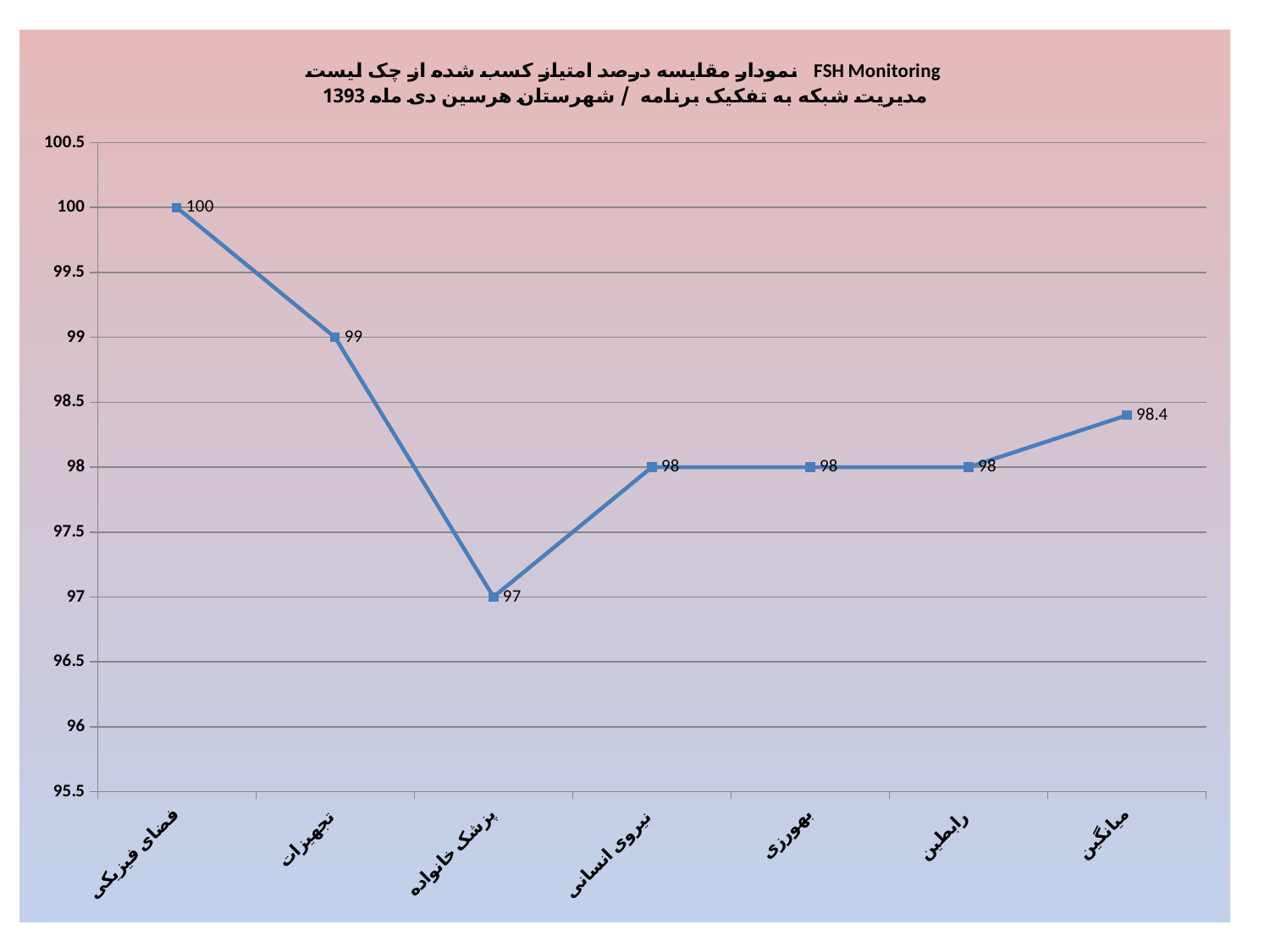
What is the value for میانگین? 98.4 What is the value for پزشک خانواده? 97 What is the value for فضای فیزیکی? 100 What type of chart is shown on the slide? line chart How many categories are plotted on the x axis? 7 What is the difference between the values for فضای فیزیکی and پزشک خانواده? 3 Do the values rise or fall from فضای فیزیکی to پزشک خانواده? fall Which category has the lowest value? پزشک خانواده Which English phrase appears in the chart title? FSH Monitoring What is the value for تجهیزات? 99 Which is larger, the value for تجهیزات or the value for میانگین? تجهیزات Which category has the highest value? فضای فیزیکی